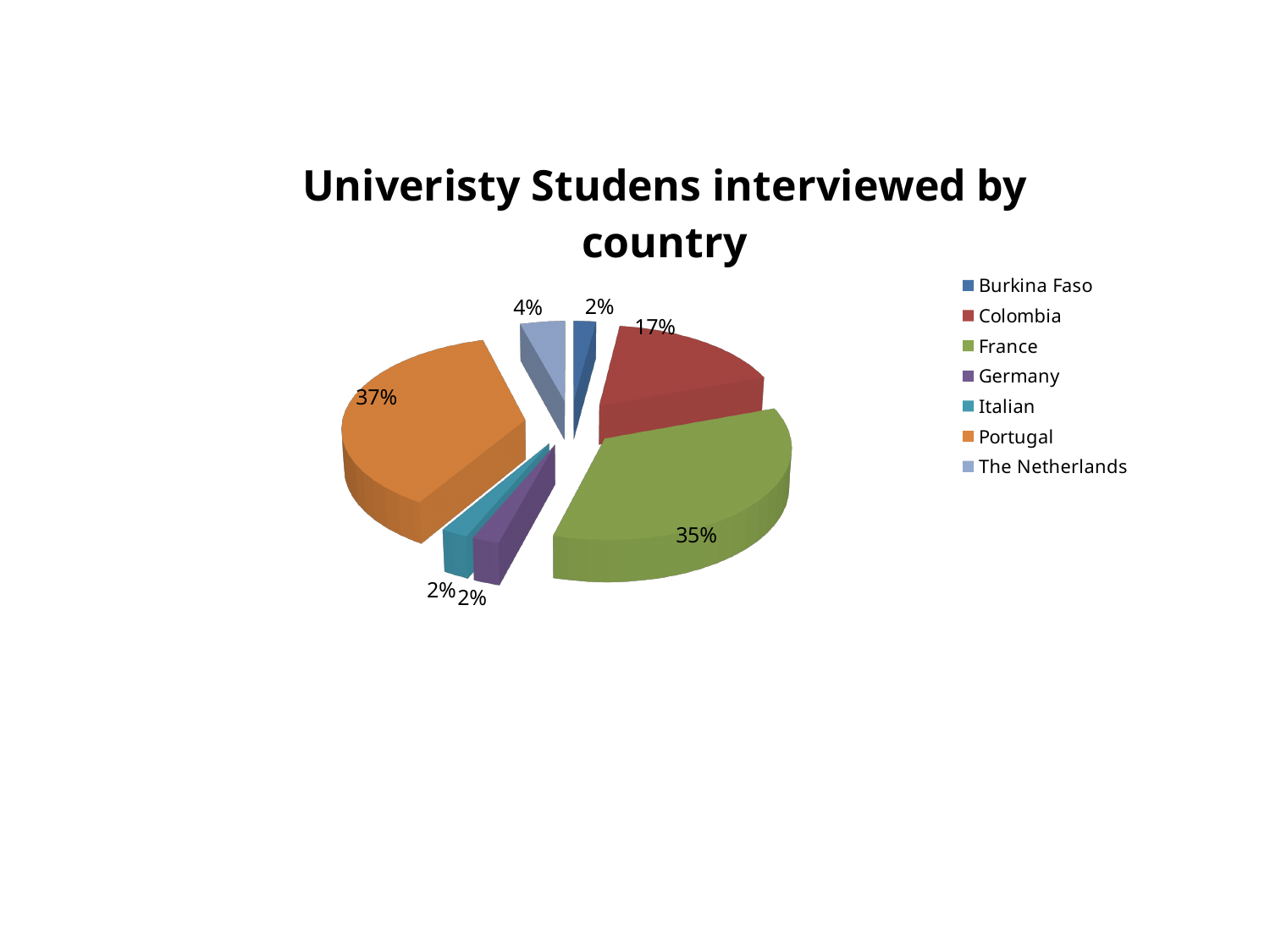
What is the title of the chart? Univeristy Studens interviewed by country What percentage of students interviewed were from The Netherlands? 4% What is the difference in percentage points between France's share and The Netherlands' share? 31 What type of chart is shown on the slide? Pie chart What is the difference in percentage points between Portugal's share and Colombia's share? 20 How many countries are listed in the chart legend? 7 Which is larger, the share for Portugal or the share for France? Portugal What share of the pie does France account for? 35% What percentage of students interviewed were from Burkina Faso? 2% Which country has the largest share of university students interviewed? Portugal What percentage of the university students interviewed were from Portugal? 37% What percentage of students interviewed were from Colombia? 17%